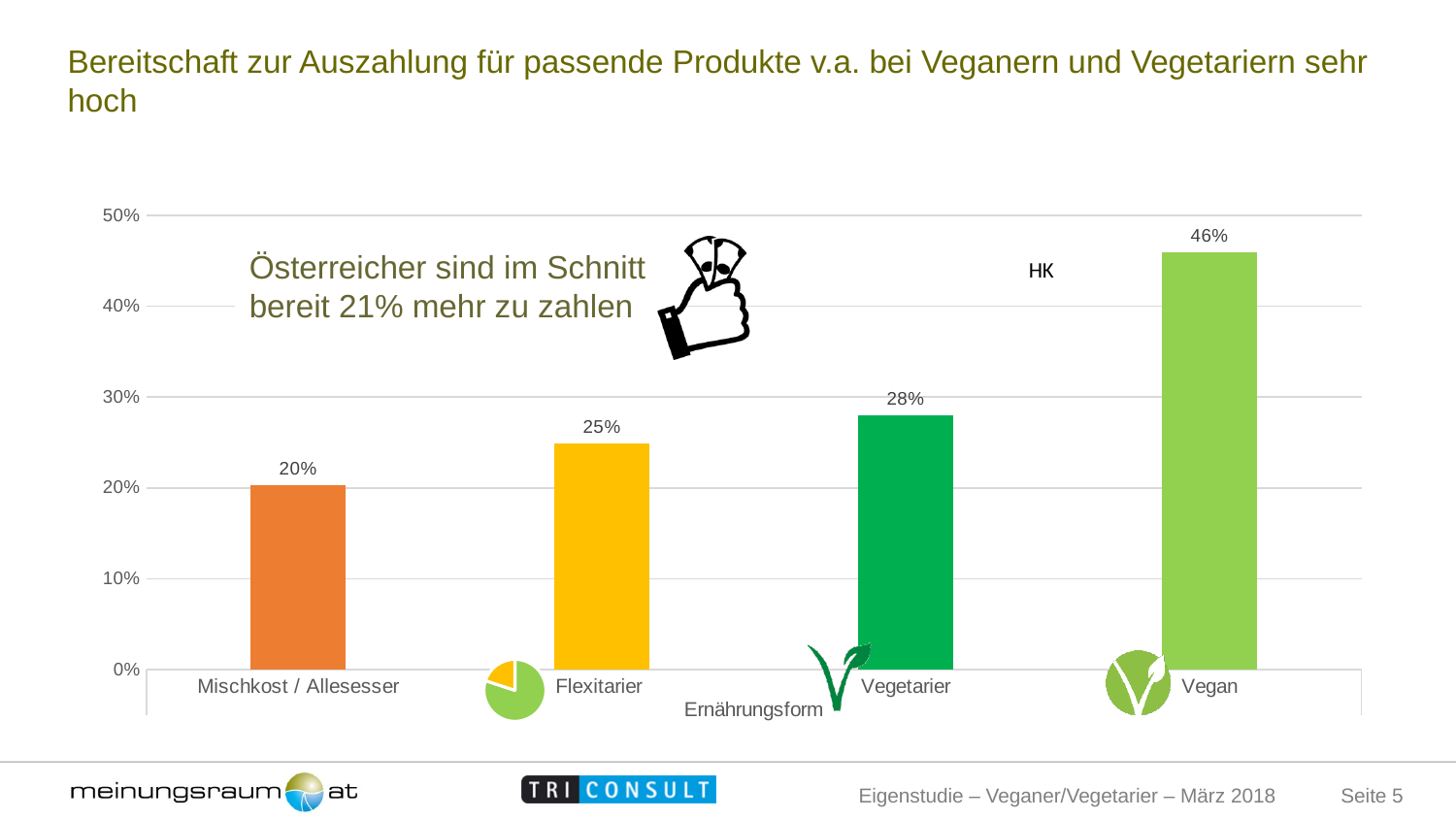
What is the difference between the values for Vegan and Vegetarier? 18% What is the value for Vegetarier? 28% What is the value for Vegan? 46% What kind of chart is shown on the slide? Bar chart Which is larger, the value for Vegetarier or the value for Flexitarier? Vegetarier What is the difference between the values for Flexitarier and Mischkost / Allesesser? 5% What is the value for Flexitarier? 25% How many categories are shown on the x axis? 4 What is the label of the x axis? Ernährungsform What is the value for Mischkost / Allesesser? 20% Which category has the highest value? Vegan Which category has the lowest value? Mischkost / Allesesser